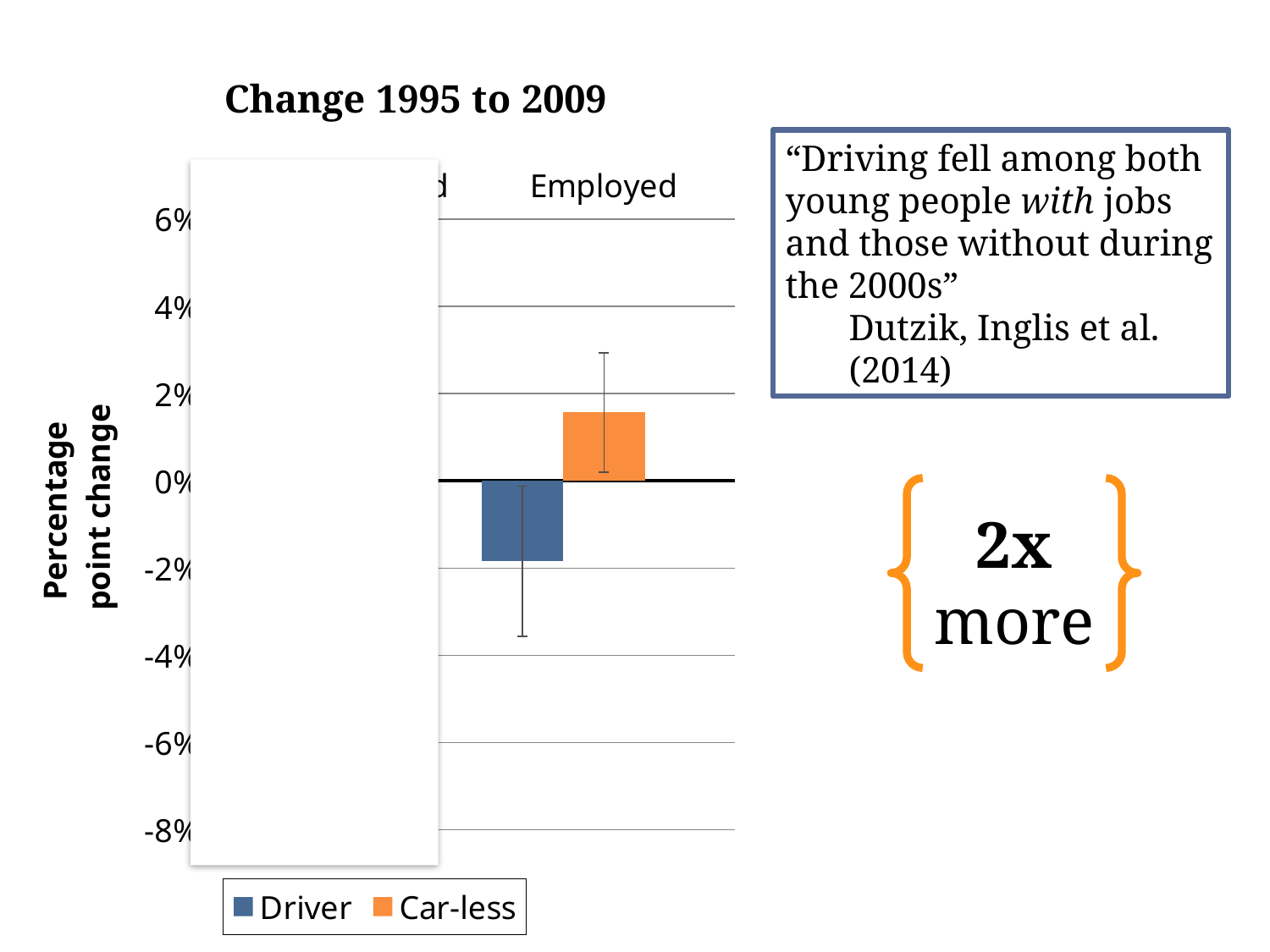
Is the Car-less value for Employed greater or less than 2%? less How many series does the chart's legend list? 2 What is the title of the chart? Change 1995 to 2009 Is the Car-less value for Employed greater or less than 4%? less What are the two series named in the legend? Driver and Car-less Is the Driver value for Employed greater or less than 0%? less What kind of chart is shown on the slide? bar chart For the Employed category, which series has the lower value? Driver For the Employed category, which series has the larger value, Driver or Car-less? Car-less